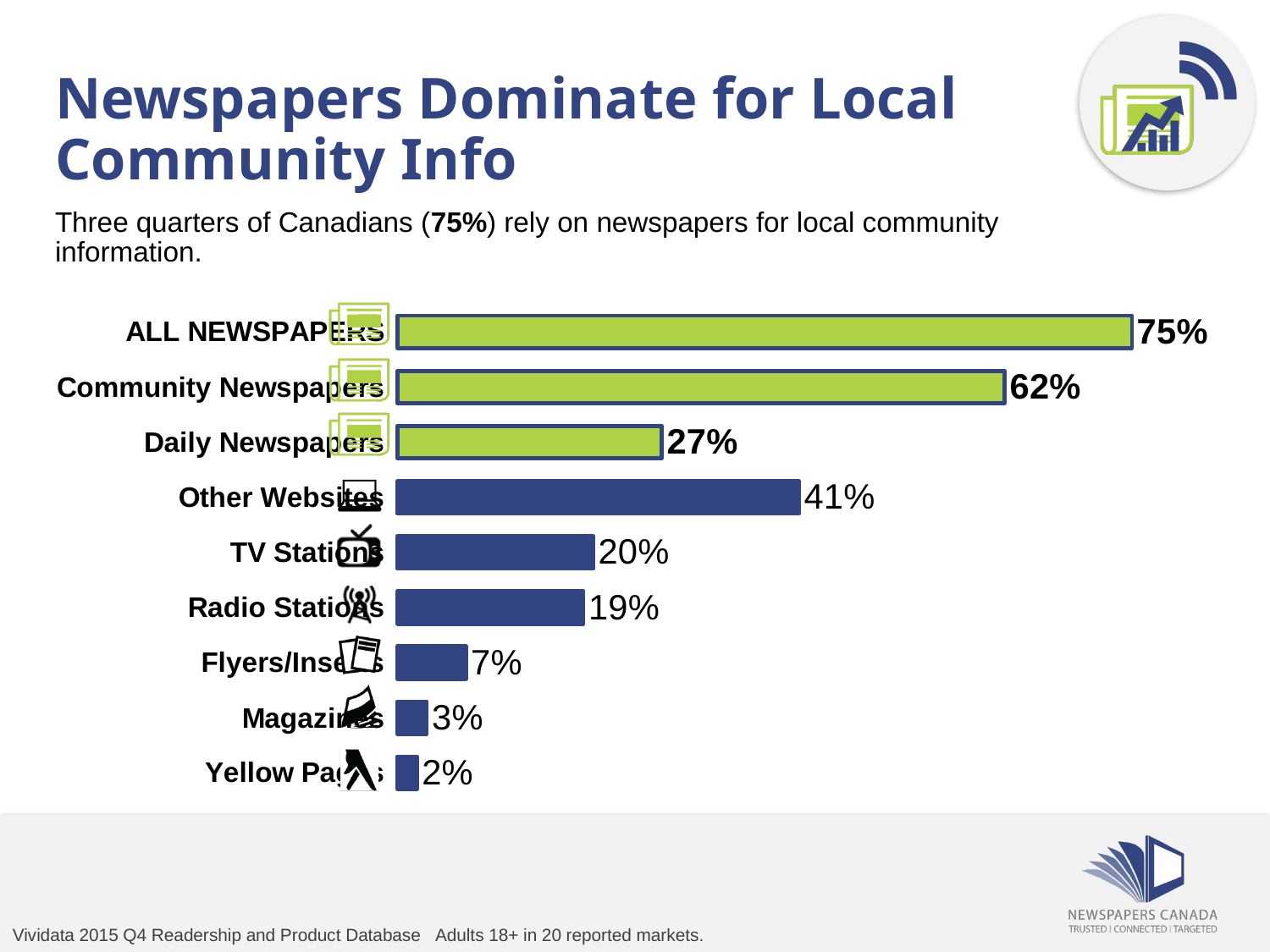
Which category has the highest value? ALL NEWSPAPERS What is the difference between the values for Other Websites and TV Stations? 21% Which is larger, the value for Daily Newspapers or the value for Other Websites? Other Websites What is the value for Radio Stations? 19% What is the value for Other Websites? 41% What is the difference between the values for Community Newspapers and Daily Newspapers? 35% Which categories have green bars rather than blue bars? ALL NEWSPAPERS, Community Newspapers, Daily Newspapers How many categories are shown in the chart? 9 What kind of chart is shown on the slide? Bar chart Which category has the lowest value? Yellow Pages What is the value for Community Newspapers? 62% What is the value for ALL NEWSPAPERS? 75%